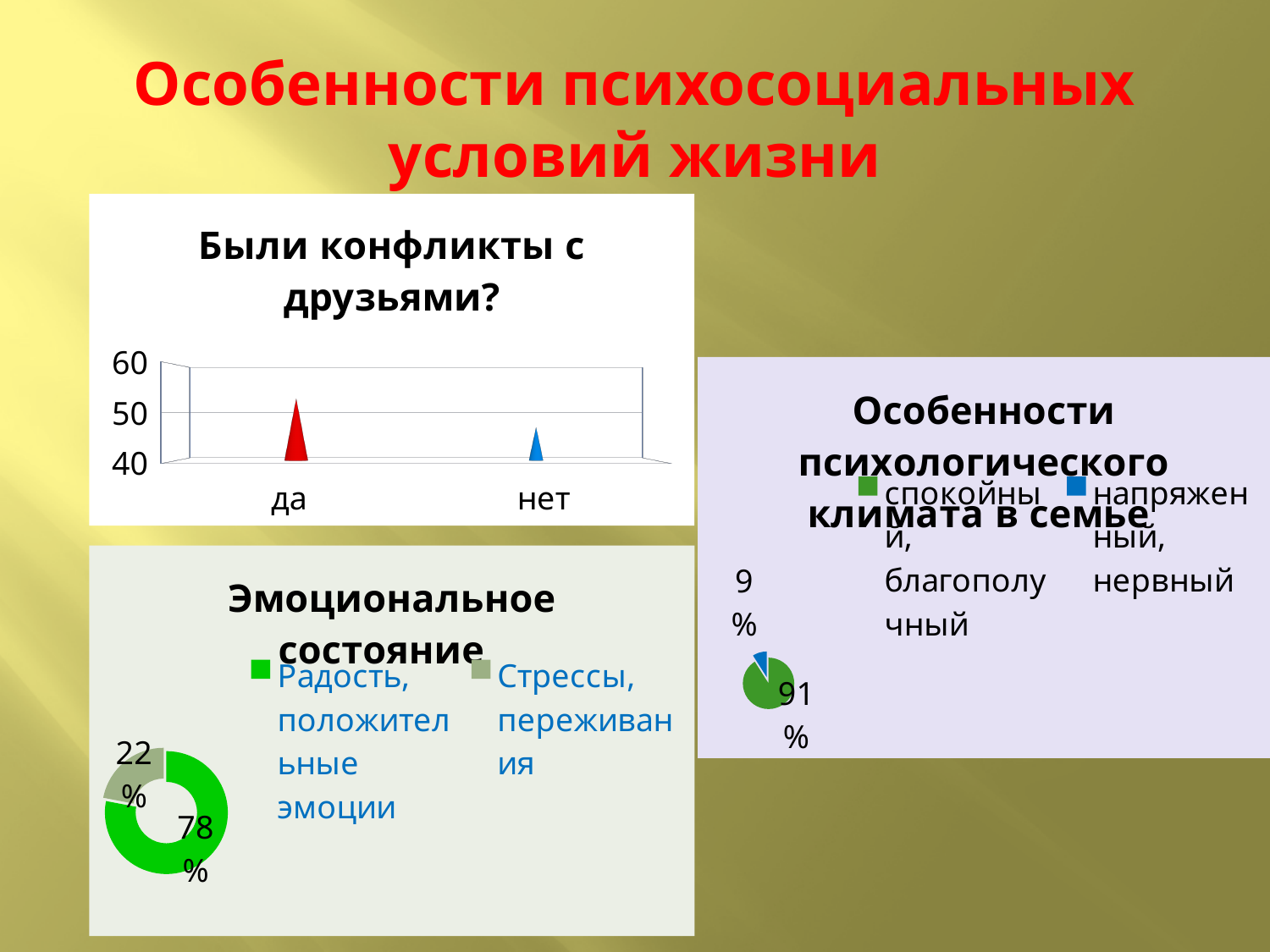
What kind of chart is 'Эмоциональное состояние'? doughnut chart In the chart 'Эмоциональное состояние', what share is labelled for 'Стрессы, переживания'? 22% In the chart 'Были конфликты с друзьями?', is the value for 'да' greater or less than 50? greater In the chart 'Были конфликты с друзьями?', which category has the higher value? да In the chart 'Были конфликты с друзьями?', is the value for 'нет' greater or less than 50? less In the chart 'Особенности психологического климата в семье', what share is labelled for 'напряженный, нервный'? 9% In the chart 'Были конфликты с друзьями?', how many categories are shown on the x axis? 2 In the chart 'Эмоциональное состояние', what share is labelled for 'Радость, положительные эмоции'? 78% In the chart 'Особенности психологического климата в семье', which category has the smallest share? напряженный, нервный In the chart 'Особенности психологического климата в семье', how many entries does the legend list? 2 In the chart 'Эмоциональное состояние', what is the difference in percentage points between 'Радость, положительные эмоции' and 'Стрессы, переживания'? 56 In the chart 'Особенности психологического климата в семье', what share is labelled for 'спокойный, благополучный'? 91%